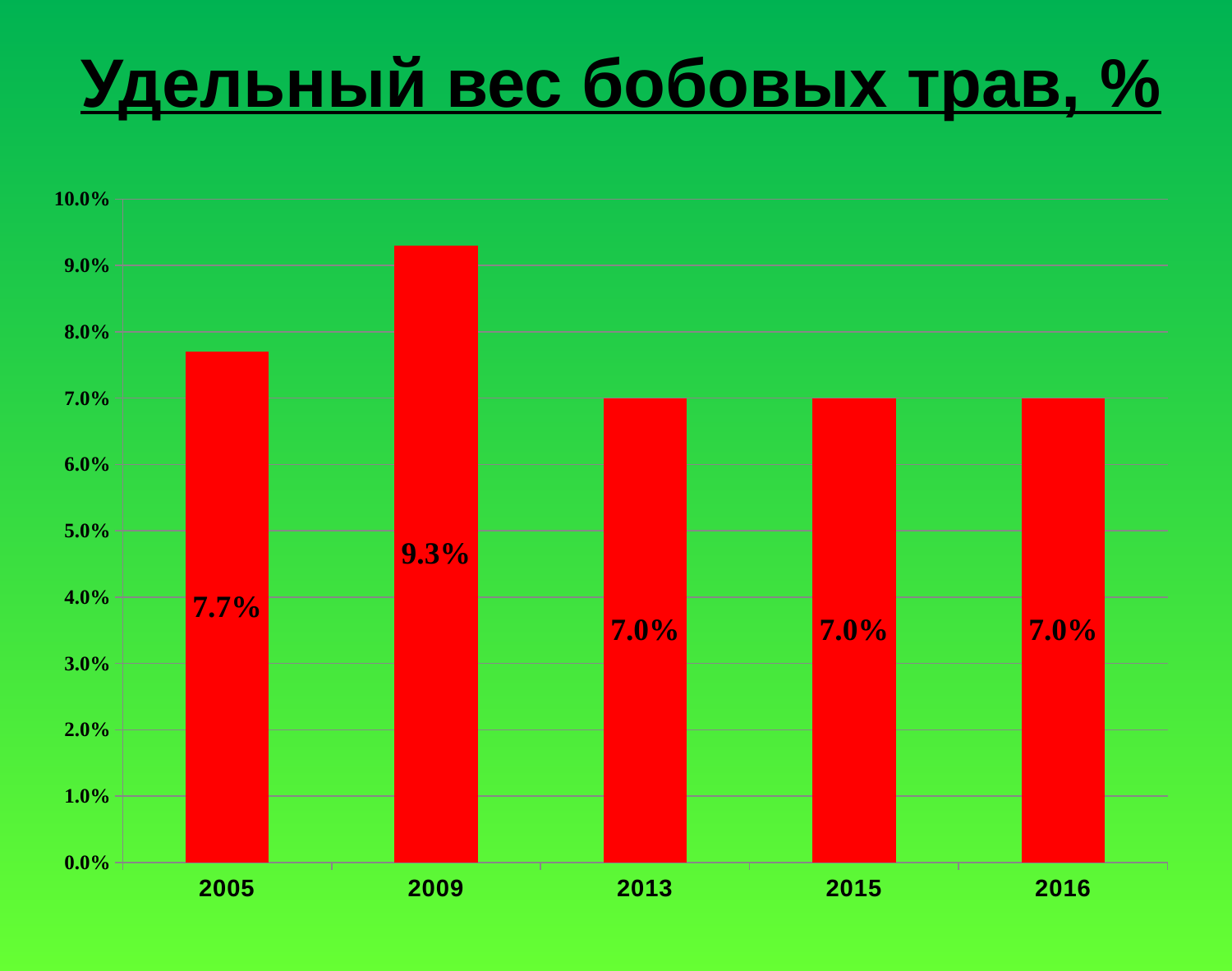
Which year has the highest value? 2009 What is the value for 2016? 7.0% How many years are shown on the x axis? 5 What is the value for 2009? 9.3% What is the title of the chart? Удельный вес бобовых трав, % What is the value for 2005? 7.7% What is the value for 2013? 7.0% Is the value for 2009 greater or less than 9.0%? greater What kind of chart is shown on the slide? bar chart What is the difference between the values for 2009 and 2005? 1.6% Which is larger, the value for 2005 or the value for 2015? 2005 What is the difference between the values for 2005 and 2013? 0.7%